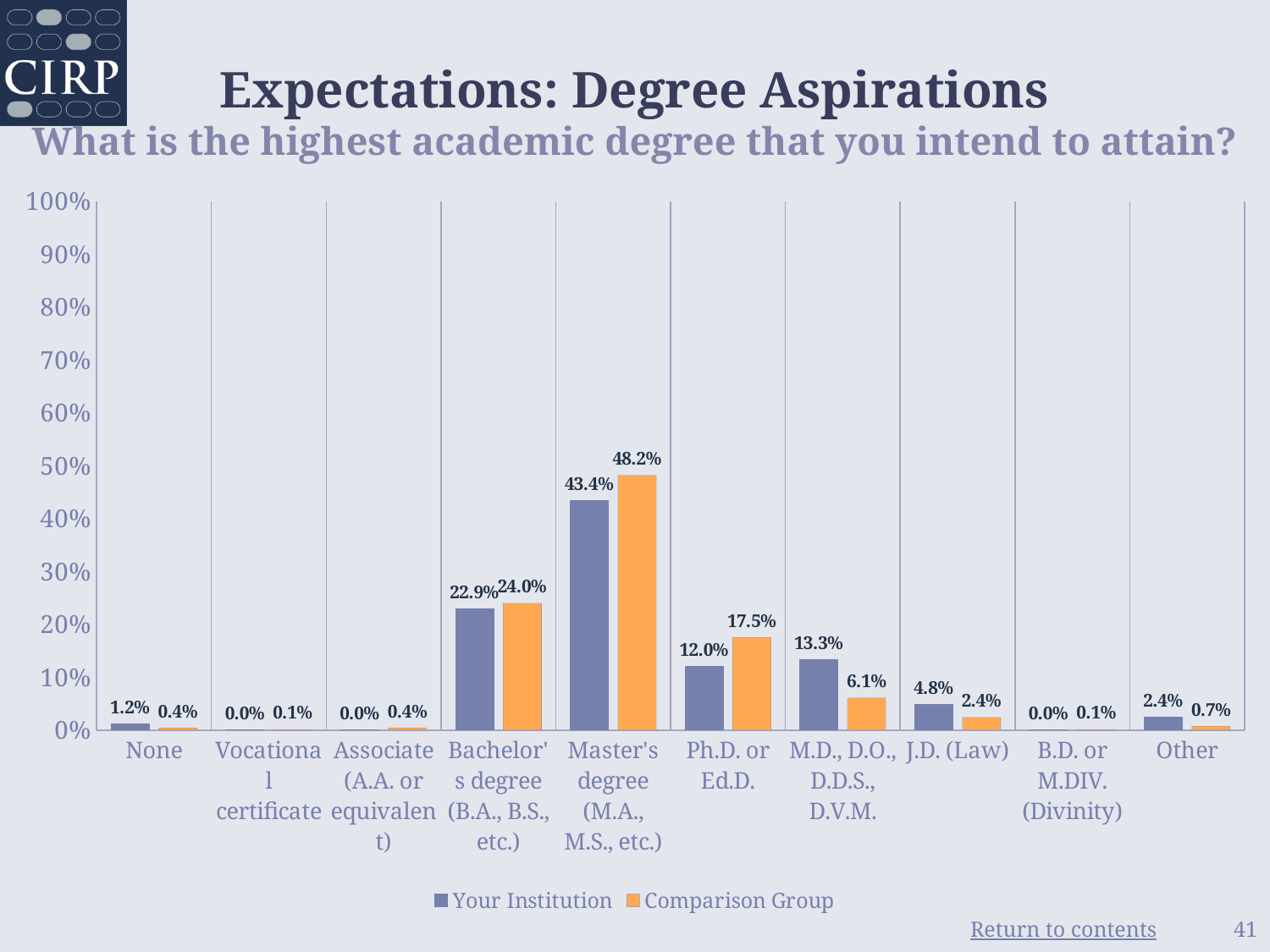
What is the value for Ph.D. or Ed.D. for the Comparison Group? 17.5% What is the value for J.D. (Law) for Your Institution? 4.8% Which category has the highest value for the Comparison Group? Master's degree (M.A., M.S., etc.) How many series does the legend list? 2 What kind of chart is shown on the slide? Bar chart What is the difference between the Comparison Group and Your Institution values for Master's degree (M.A., M.S., etc.)? 4.8% What colour are the bars for the Comparison Group series? Orange For M.D., D.O., D.D.S., D.V.M., which series has the larger value, Your Institution or Comparison Group? Your Institution What is the difference between Your Institution and the Comparison Group for M.D., D.O., D.D.S., D.V.M.? 7.2% How many degree categories are shown on the x axis? 10 What is the value for Master's degree (M.A., M.S., etc.) for Your Institution? 43.4% For Bachelor's degree (B.A., B.S., etc.), which series has the larger value, Your Institution or Comparison Group? Comparison Group